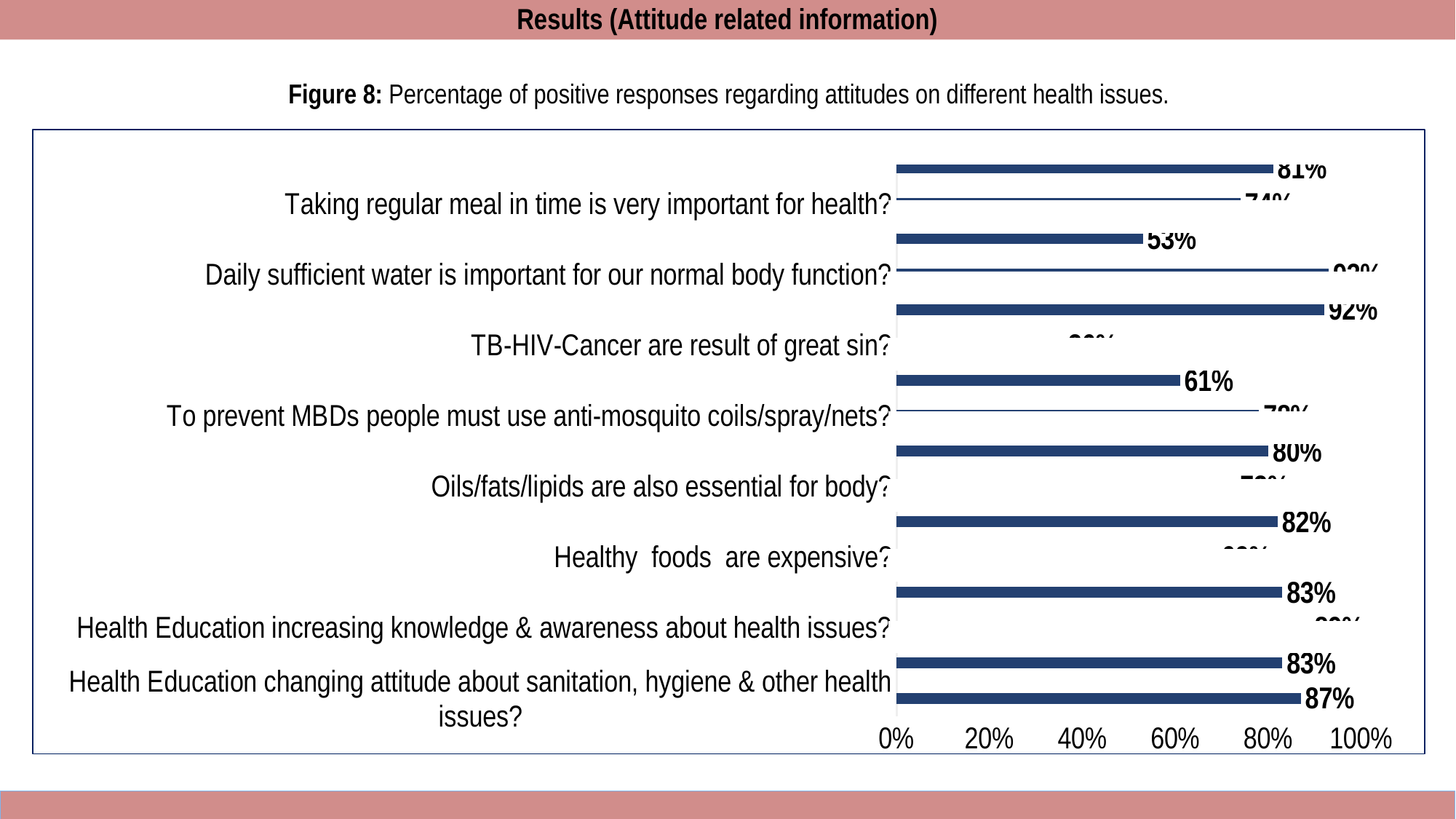
Is the thin lower bar for "Daily sufficient water is important for our normal body function?" greater or less than 80%? greater What kind of chart is shown on the slide? bar chart What is the value of the thin lower bar for "Health Education changing attitude about sanitation, hygiene & other health issues?" 87% What is the highest value shown on the horizontal axis? 100% How many health-issue statements (categories) are listed on the chart? 16